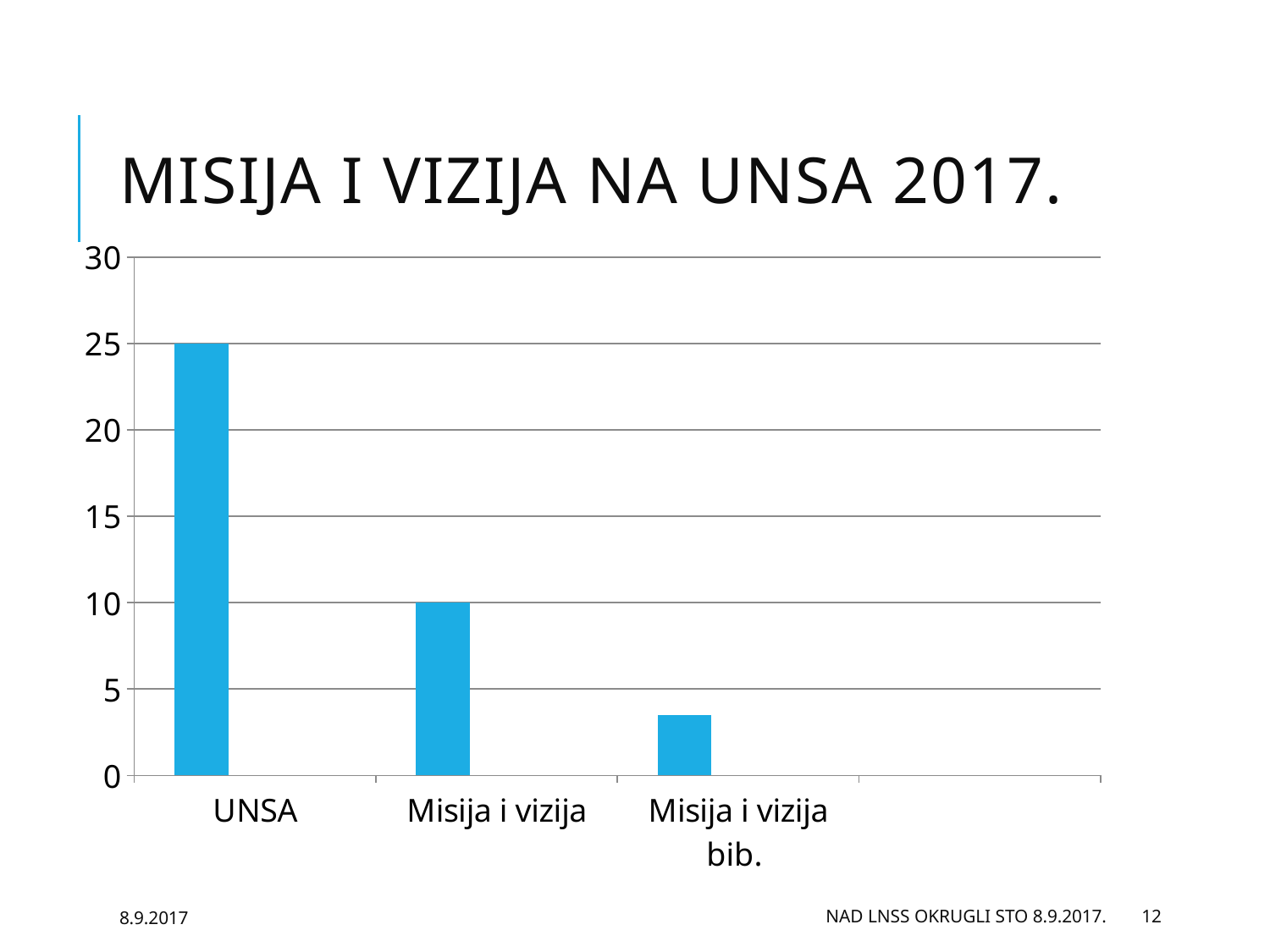
Which category has the lowest value? Misija i vizija bib. What kind of chart is shown on the slide? bar chart Which is larger, the value for Misija i vizija or the value for Misija i vizija bib.? Misija i vizija What is the value for Misija i vizija? 10 Which category has the highest value? UNSA What is the difference between the values for UNSA and Misija i vizija? 15 What is the value for UNSA? 25 Do the values rise or fall from left to right along the x axis? fall Is the value for UNSA greater or less than 20? greater How many categories are shown on the x axis? 3 What is the title of the slide containing the chart? MISIJA I VIZIJA NA UNSA 2017. Is the value for Misija i vizija bib. greater or less than 5? less